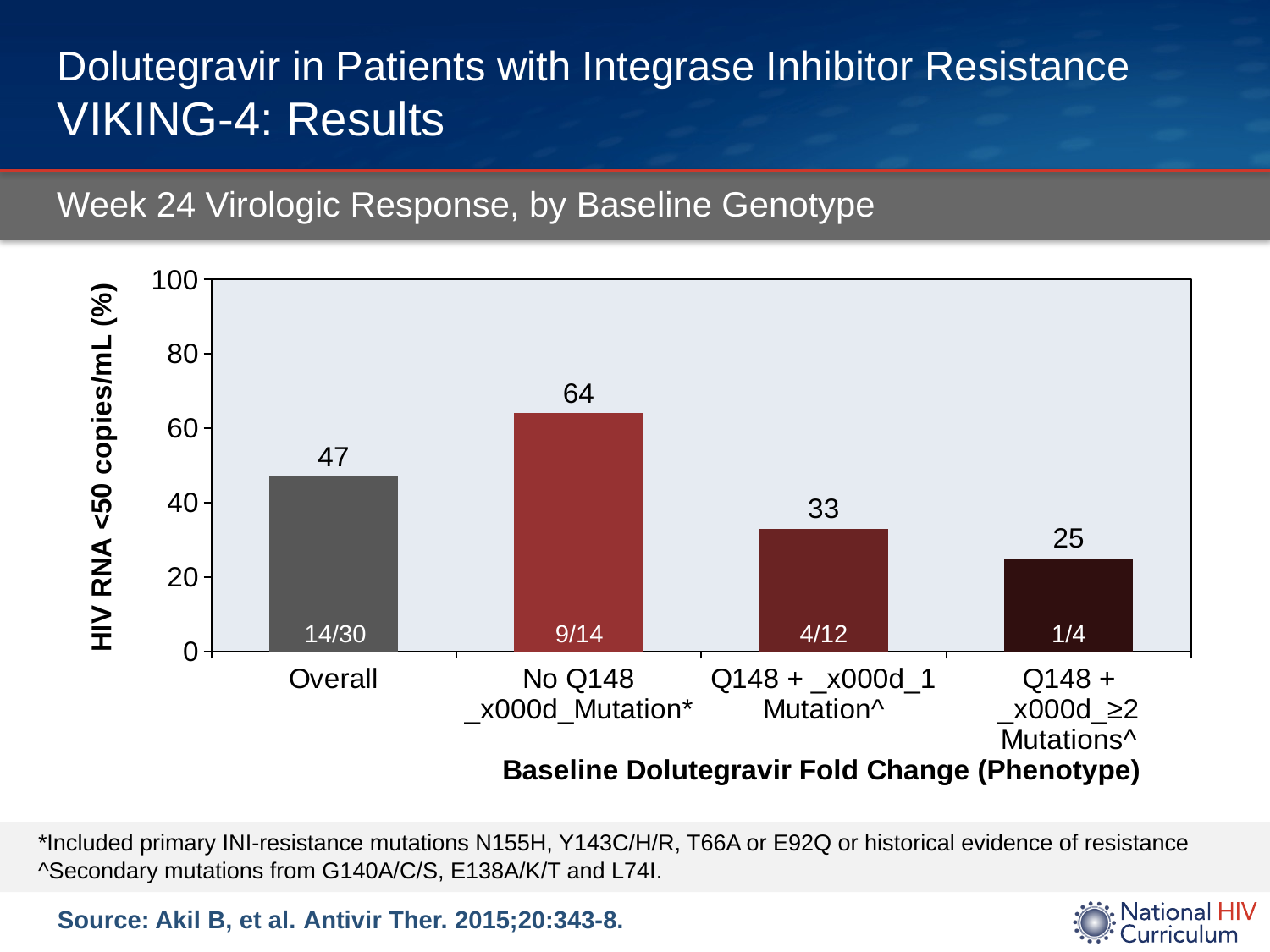
What is the value for the Overall bar? 47 Which is larger, the value for Overall or the value for Q148 + 1 Mutation? Overall What fraction of patients is shown inside the Overall bar? 14/30 What is the value for the No Q148 Mutation bar? 64 What is the value for the Q148 + 1 Mutation bar? 33 Which category has the lowest value? Q148 + ≥2 Mutations How many categories are shown on the x axis? 4 What fraction of patients is shown inside the Q148 + ≥2 Mutations bar? 1/4 What is the label of the y axis? HIV RNA <50 copies/mL (%) What kind of chart is shown on the slide? Bar chart Which category has the highest value? No Q148 Mutation What is the difference between the No Q148 Mutation value and the Q148 + ≥2 Mutations value? 39